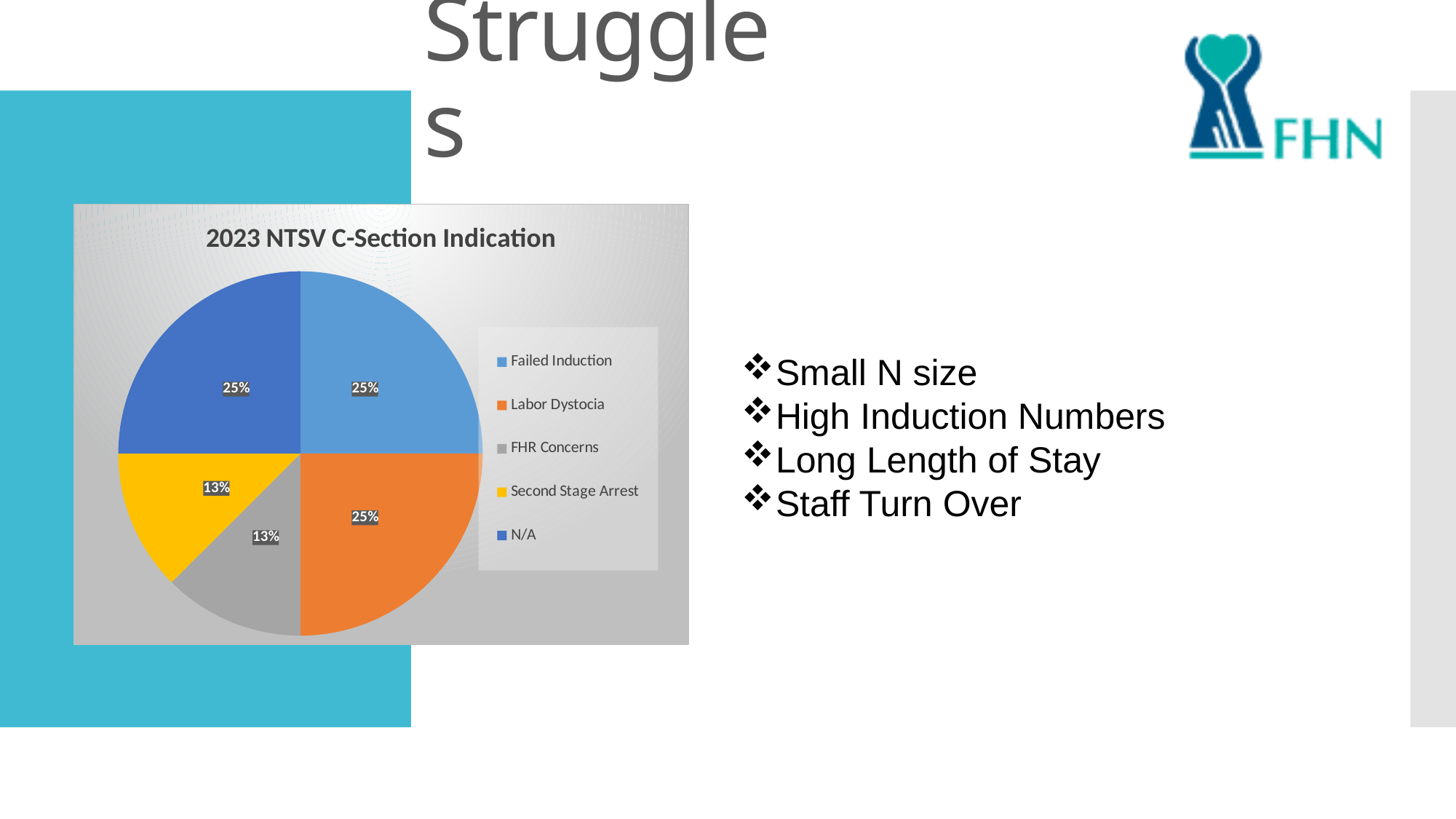
What percentage is shown for FHR Concerns? 13% How many categories does the legend list? 5 Which is larger, the share for Failed Induction or the share for FHR Concerns? Failed Induction Which is larger, the share for Second Stage Arrest or the share for N/A? N/A What percentage is shown for N/A? 25% What share of the pie does Failed Induction represent? 25% What is the difference in percentage points between Labor Dystocia and Second Stage Arrest? 12 What type of chart is shown on the slide? pie chart What colour is the slice for Second Stage Arrest? yellow What percentage is shown for Second Stage Arrest? 13% What is the title of the chart? 2023 NTSV C-Section Indication What share of the pie does Labor Dystocia represent? 25%